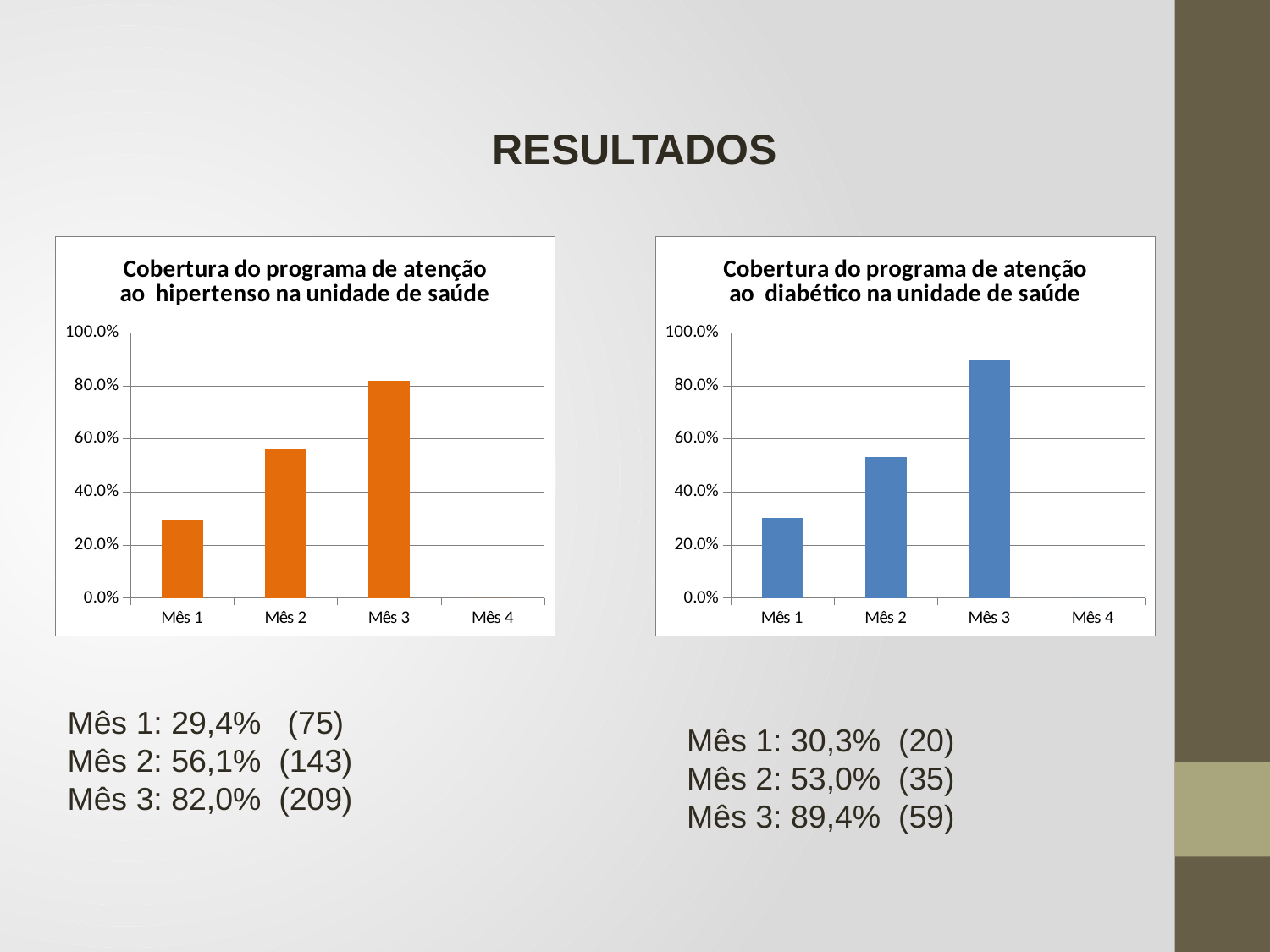
In the 'Cobertura do programa de atenção ao hipertenso na unidade de saúde' chart, is the value for Mês 1 greater or less than 40.0%? less In the 'Cobertura do programa de atenção ao diabético na unidade de saúde' chart, is the value for Mês 2 greater or less than 60.0%? less How many month categories are shown on the x axis of the 'Cobertura do programa de atenção ao diabético na unidade de saúde' chart? 4 According to the text under the 'Cobertura do programa de atenção ao diabético na unidade de saúde' chart, what is the coverage for Mês 3? 89,4% In the 'Cobertura do programa de atenção ao hipertenso na unidade de saúde' chart, do the values rise or fall from Mês 1 to Mês 3? rise According to the text under the 'Cobertura do programa de atenção ao hipertenso na unidade de saúde' chart, what is the coverage for Mês 2? 56,1% What kind of chart is the 'Cobertura do programa de atenção ao hipertenso na unidade de saúde' chart? bar chart In the 'Cobertura do programa de atenção ao hipertenso na unidade de saúde' chart, which month has the highest value? Mês 3 Which is larger: the Mês 3 value in the hipertenso chart or the Mês 3 value in the diabético chart? the diabético chart In the 'Cobertura do programa de atenção ao diabético na unidade de saúde' chart, which month among those with a bar has the lowest value? Mês 1 What colour are the bars in the 'Cobertura do programa de atenção ao diabético na unidade de saúde' chart? blue In the 'Cobertura do programa de atenção ao hipertenso na unidade de saúde' chart, is the value for Mês 3 greater or less than 80.0%? greater